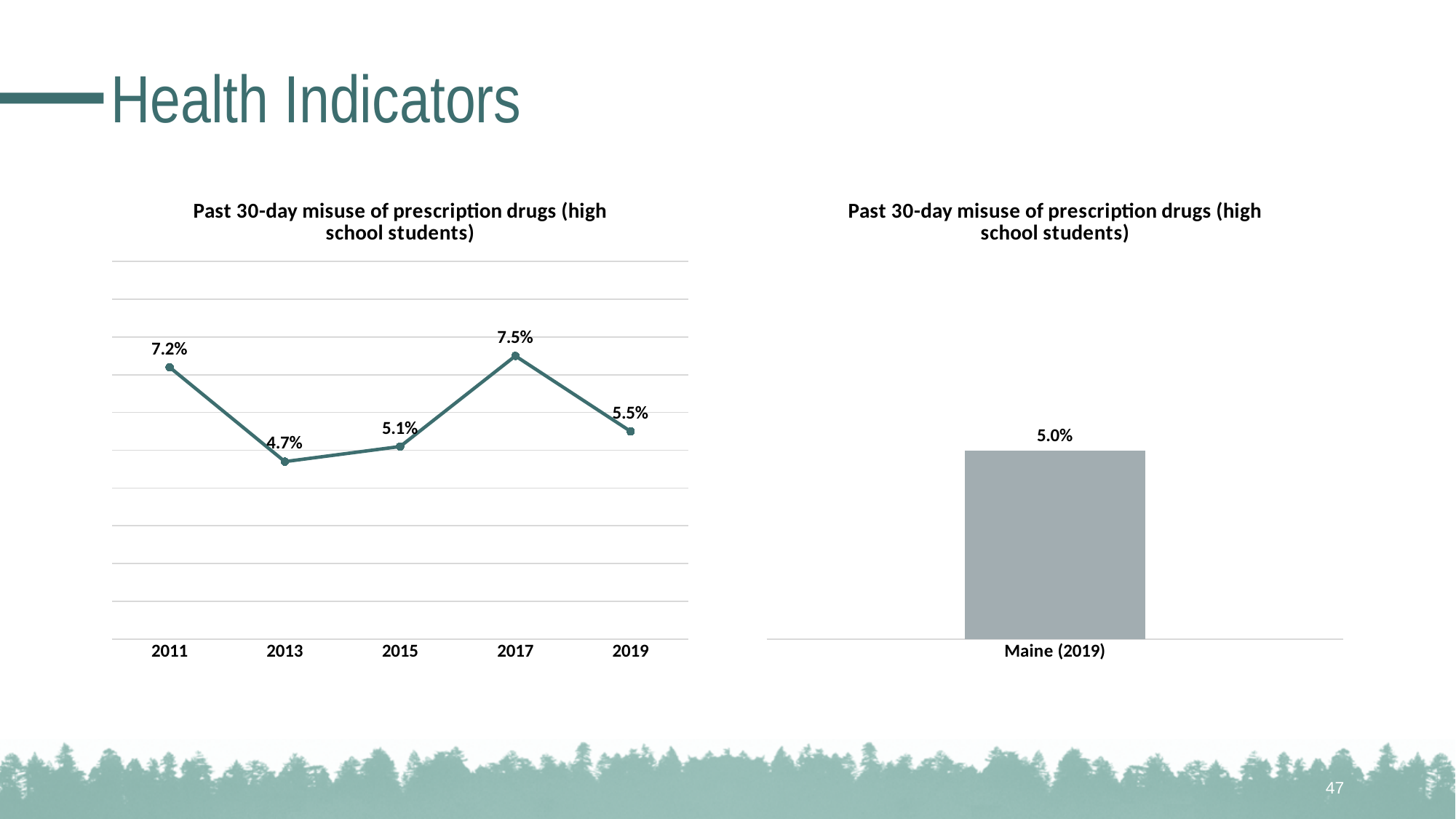
In the right-hand chart, what is the value for Maine (2019)? 5.0% What kind of chart is the right-hand chart? bar chart In the left-hand line chart, which year has the lowest value? 2013 In the left-hand line chart, what is the difference between the 2017 value and the 2019 value? 2.0% In the left-hand line chart, does the value rise or fall from 2017 to 2019? fall How many data points are plotted in the left-hand line chart? 5 In the left-hand line chart, what is the value for 2013? 4.7% In the left-hand line chart, which is larger, the value for 2015 or the value for 2019? 2019 In the left-hand line chart, what is the value for 2017? 7.5% In the left-hand line chart, what is the value for 2019? 5.5% In the left-hand line chart, what is the value for 2011? 7.2% In the left-hand line chart, which year has the highest value? 2017